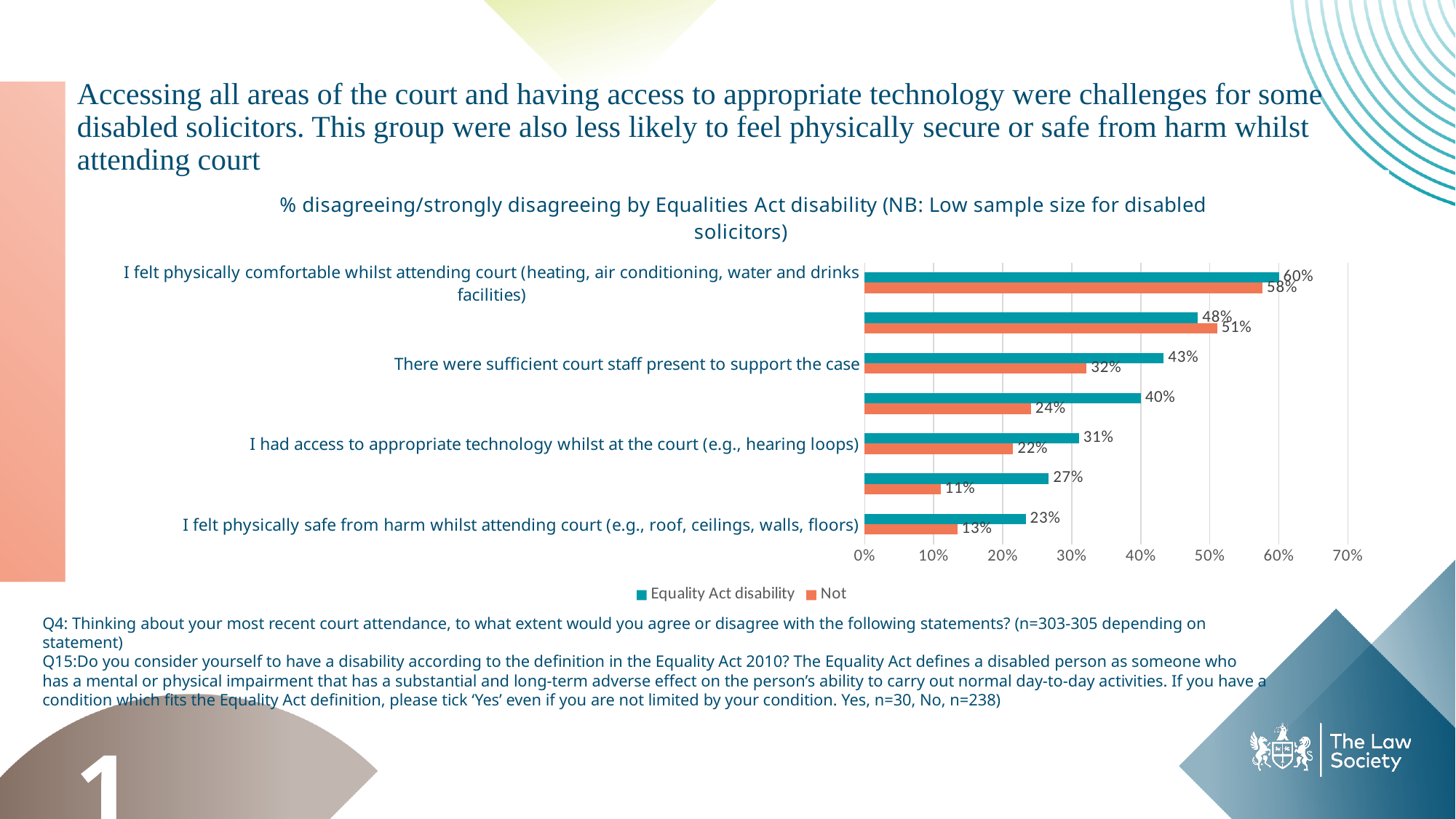
How many statements (pairs of bars) are plotted in the chart? 7 What is the Equality Act disability value for 'I felt physically comfortable whilst attending court (heating, air conditioning, water and drinks facilities)'? 60% How many series does the legend list? 2 Which labelled statement has the highest Equality Act disability value? I felt physically comfortable whilst attending court (heating, air conditioning, water and drinks facilities) What is the difference between the Equality Act disability and 'Not' values for 'There were sufficient court staff present to support the case'? 11 percentage points For 'I had access to appropriate technology whilst at the court (e.g., hearing loops)', which series has the larger value: Equality Act disability or Not? Equality Act disability What is the 'Not' value for 'I felt physically safe from harm whilst attending court (e.g., roof, ceilings, walls, floors)'? 13% What are the two series named in the legend? Equality Act disability; Not What is the 'Not' value for 'There were sufficient court staff present to support the case'? 32% Which labelled statement has the lowest Equality Act disability value? I felt physically safe from harm whilst attending court (e.g., roof, ceilings, walls, floors) What is the Equality Act disability value for 'I had access to appropriate technology whilst at the court (e.g., hearing loops)'? 31% What type of chart is shown on the slide? Bar chart